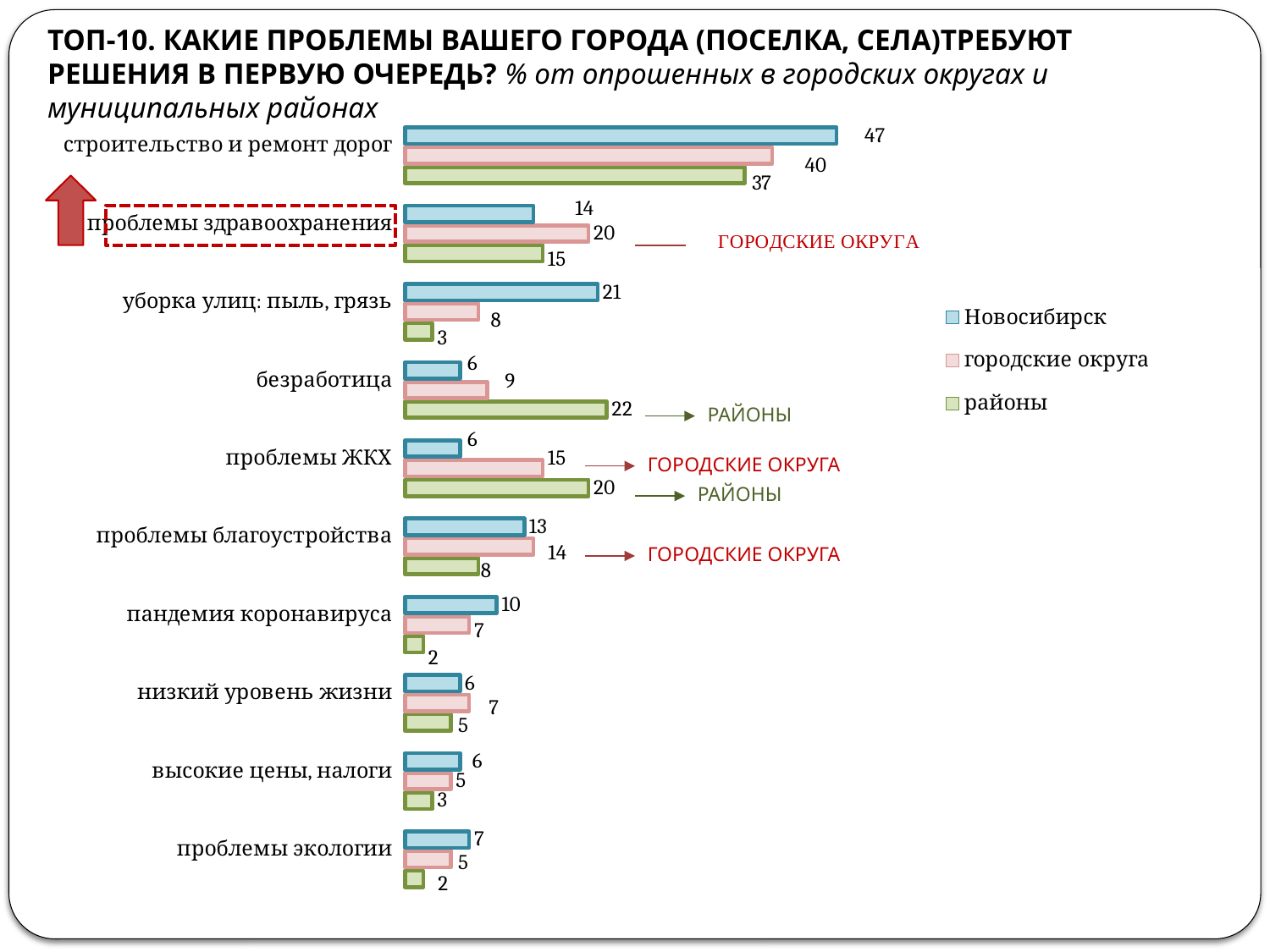
What is the difference between the Новосибирск and районы values for "уборка улиц: пыль, грязь"? 18 What is the value for городские округа for "проблемы благоустройства"? 14 Which category has the lowest value for районы? пандемия коронавируса and проблемы экологии (both 2) What is the value for Новосибирск for "строительство и ремонт дорог"? 47 How many problem categories are plotted on the chart? 10 What is the value for городские округа for "проблемы здравоохранения"? 20 What is the value for районы for "безработица"? 22 For "проблемы ЖКХ", which is larger: the value for городские округа or the value for районы? районы Which legend entry is shown in green? районы What type of chart is shown on the slide? bar chart Which category has the highest value for Новосибирск? строительство и ремонт дорог How many series does the legend list? 3